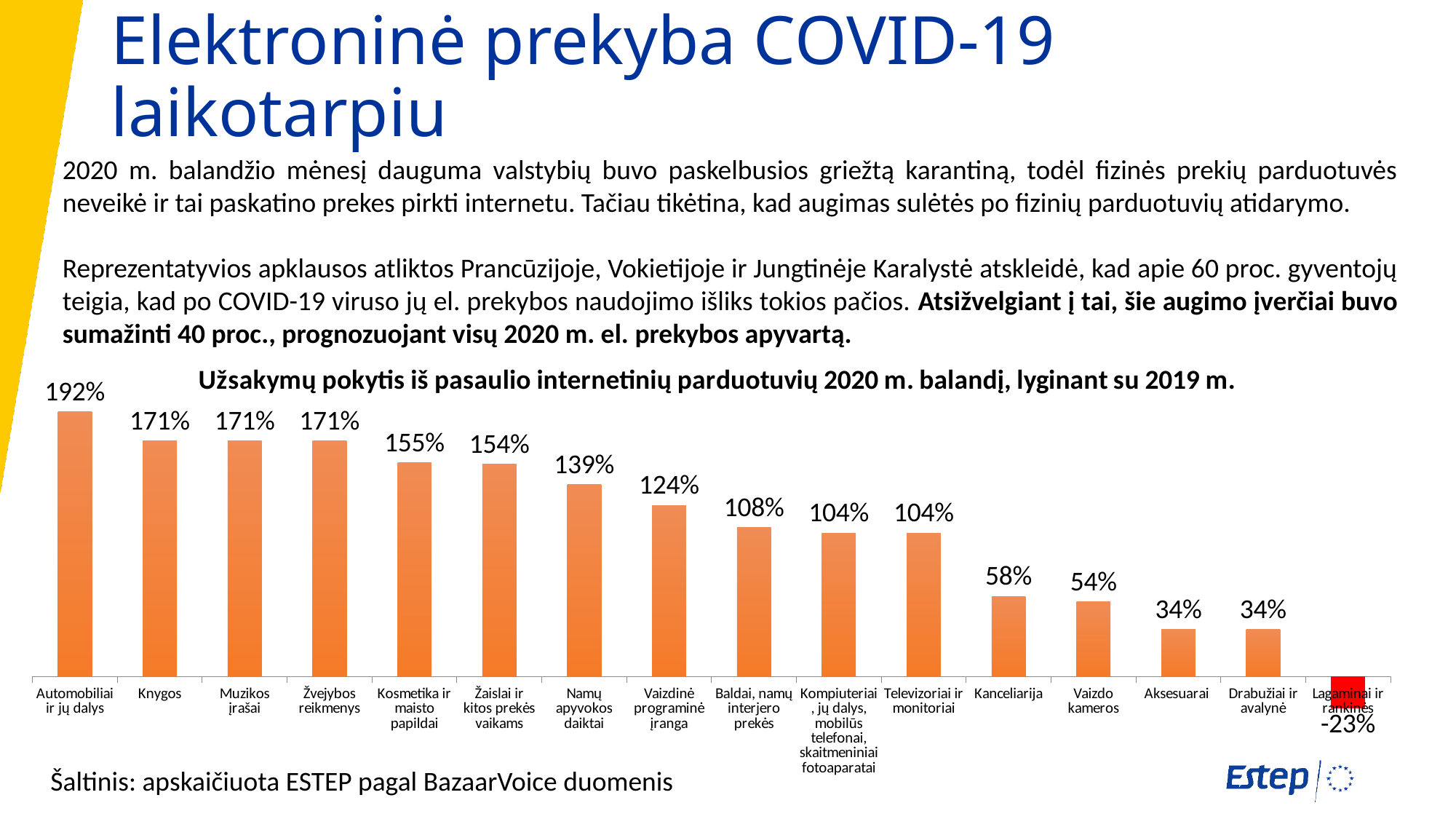
Which category has the lowest value? Lagaminai ir rankinės What is the value for Lagaminai ir rankinės? -23% What is the value for Kanceliarija? 58% Which category has the highest value? Automobiliai ir jų dalys What is the value for Namų apyvokos daiktai? 139% How many categories are shown in the chart? 16 What is the difference between the values for Kosmetika ir maisto papildai and Žaislai ir kitos prekės vaikams? 1% What is the value for Automobiliai ir jų dalys? 192% Which is larger, the value for Vaizdinė programinė įranga or the value for Baldai, namų interjero prekės? Vaizdinė programinė įranga What is the title of the chart? Užsakymų pokytis iš pasaulio internetinių parduotuvių 2020 m. balandį, lyginant su 2019 m. What is the difference between the values for Knygos and Vaizdo kameros? 117% What type of chart is shown on the slide? bar chart